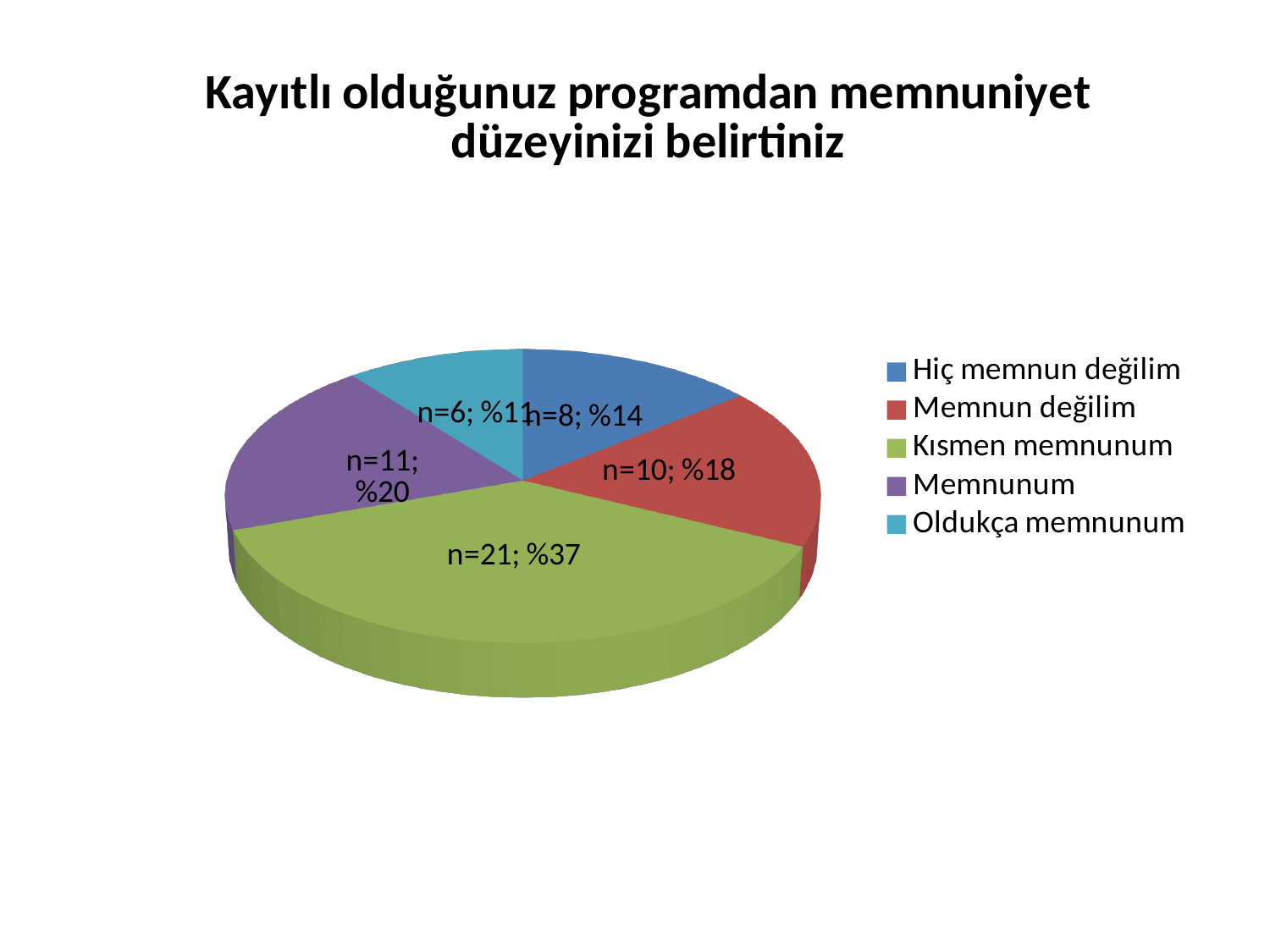
What is the count (n) for the 'Kısmen memnunum' slice? n=21 What percentage share does the 'Kısmen memnunum' slice have? %37 Which category has the largest slice? Kısmen memnunum What colour is the 'Oldukça memnunum' slice? light blue Which category has the smallest slice? Oldukça memnunum How many slices does the pie chart have? 5 What percentage share does the 'Memnunum' slice have? %20 What kind of chart is shown on the slide? pie chart What is the title of the chart? Kayıtlı olduğunuz programdan memnuniyet düzeyinizi belirtiniz Which has a larger count, 'Memnunum' or 'Memnun değilim'? Memnunum What is the difference in count (n) between 'Kısmen memnunum' and 'Memnun değilim'? 11 What is the count (n) for the 'Hiç memnun değilim' slice? n=8